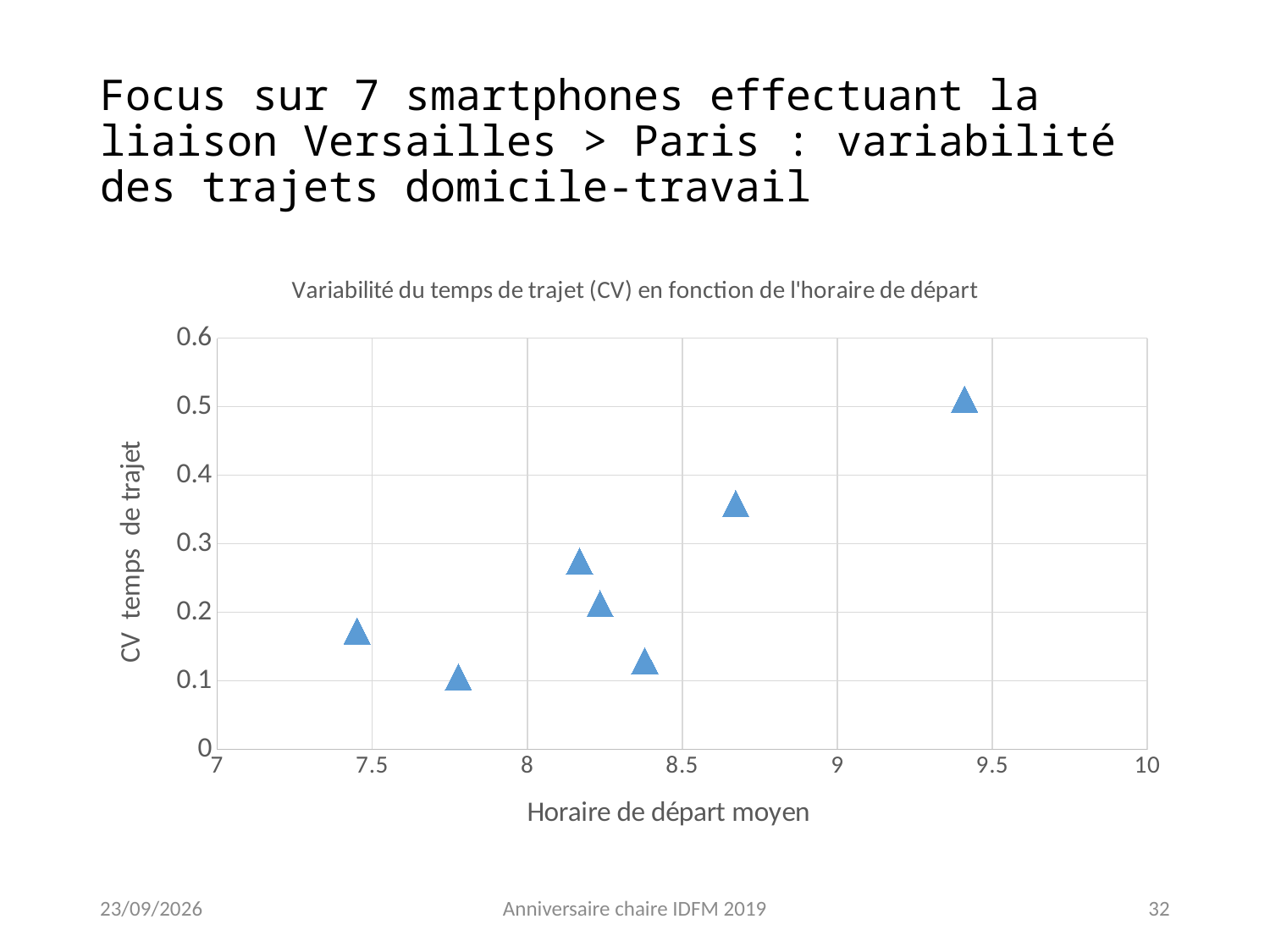
Is the CV value for the point with a departure time around 8.7 greater or less than 0.3? greater What is the title of the chart? Variabilité du temps de trajet (CV) en fonction de l'horaire de départ How many data points are plotted on the chart? 7 Which point has the highest CV temps de trajet on the chart? the point with departure time around 9.4 Is the CV value for the point with a departure time around 7.8 greater or less than 0.2? less Is the CV value for the point with a departure time around 7.45 greater or less than 0.3? less Which point has the lowest CV temps de trajet on the chart? the point with departure time around 7.8 What is the label of the horizontal axis? Horaire de départ moyen Which point has the highest CV temps de trajet: the one with departure time around 9.4 or the one around 8.7? the one around 9.4 What kind of chart is shown on the slide? scatter chart